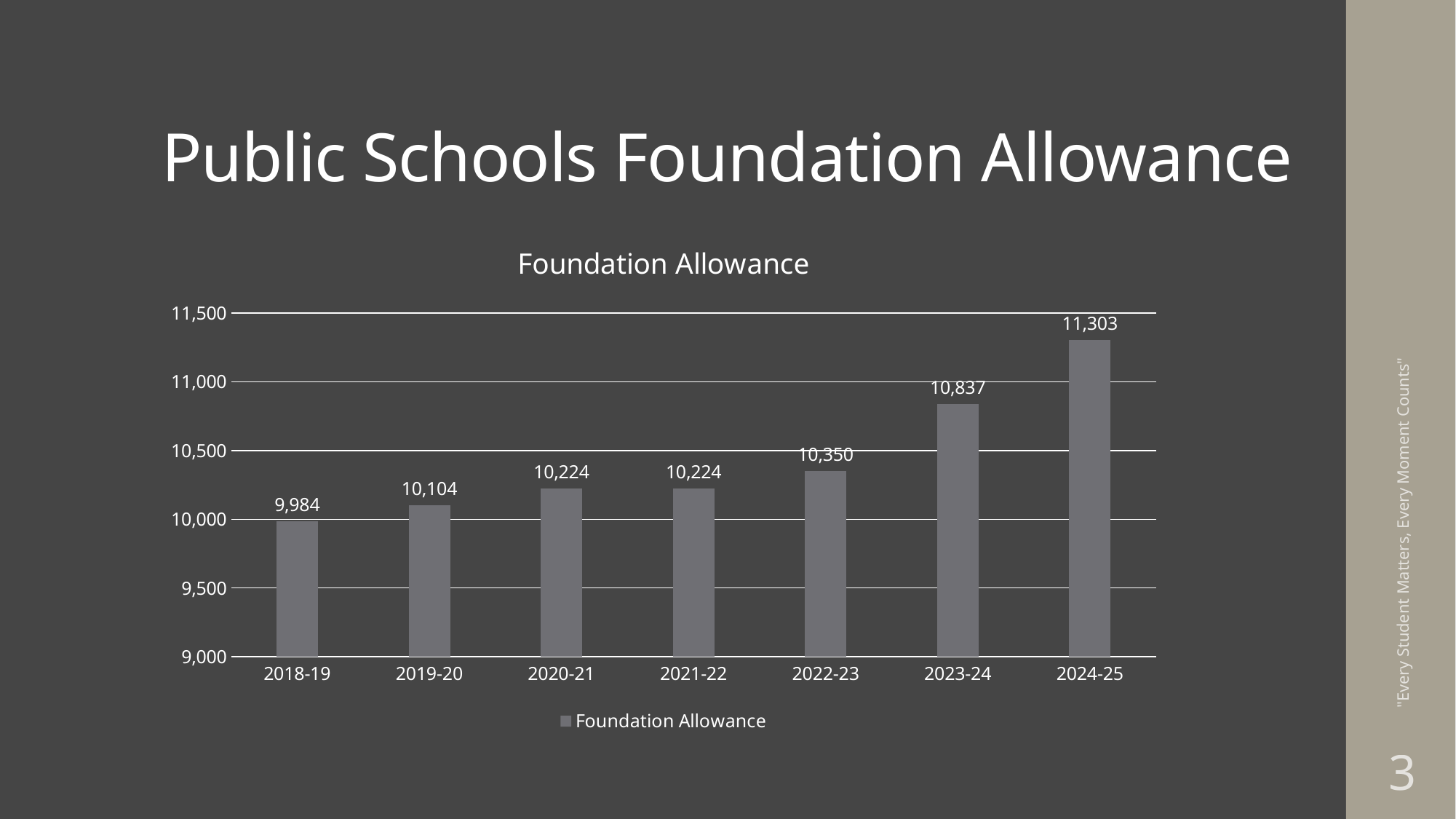
Which year has the highest Foundation Allowance? 2024-25 What is the Foundation Allowance value for 2018-19? 9,984 What is the difference between the Foundation Allowance for 2024-25 and 2023-24? 466 How many years are shown on the x axis of the chart? 7 What is the Foundation Allowance value for 2022-23? 10,350 What is the difference between the Foundation Allowance for 2019-20 and 2018-19? 120 Which year has the lowest Foundation Allowance? 2018-19 Which is larger, the Foundation Allowance for 2022-23 or for 2021-22? 2022-23 Is the Foundation Allowance for 2023-24 greater or less than 11,000? less Do the Foundation Allowance values generally rise or fall from 2018-19 to 2024-25? rise What is the Foundation Allowance value for 2024-25? 11,303 What kind of chart is shown on the slide? bar chart